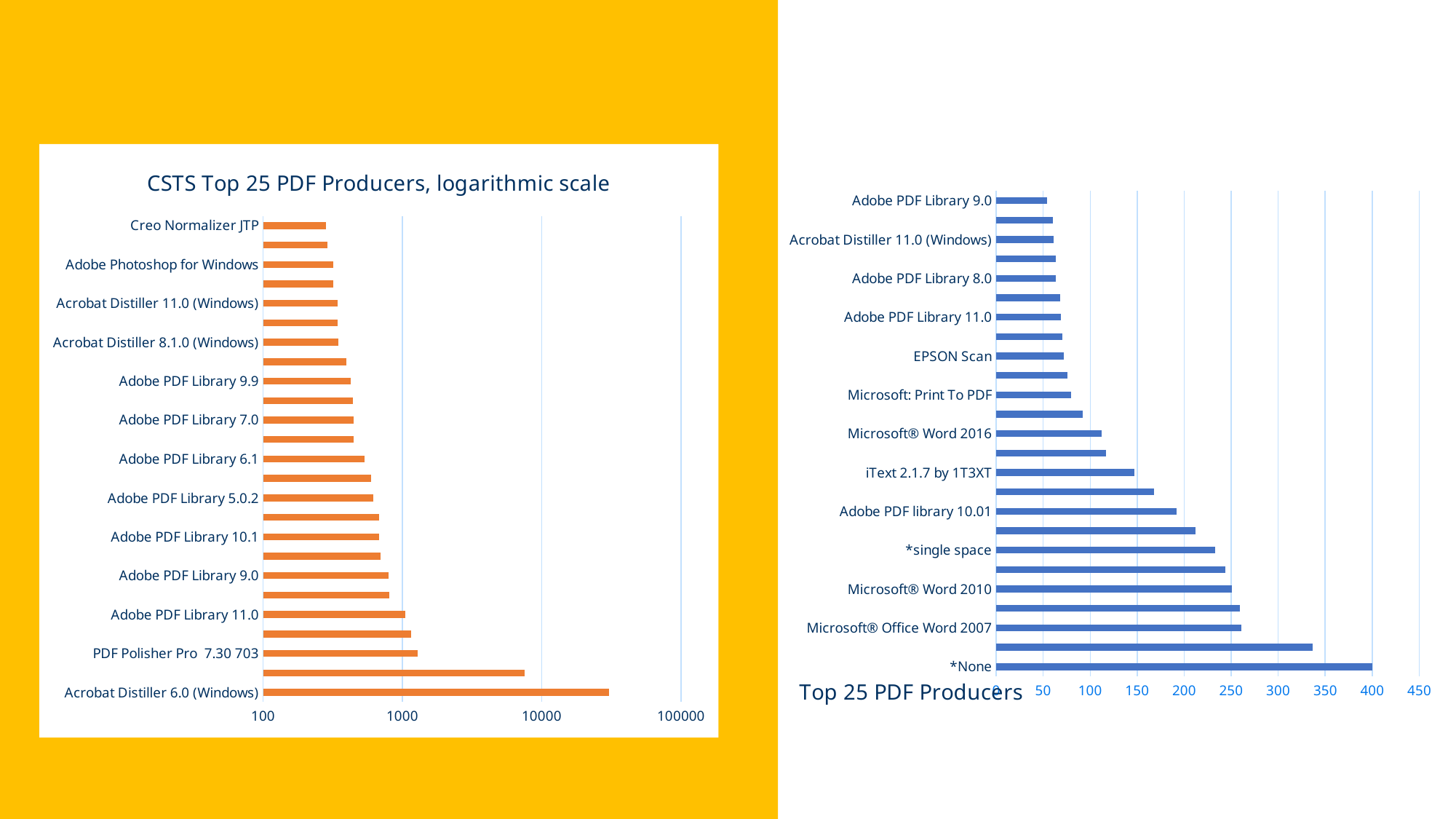
In the 'CSTS Top 25 PDF Producers, logarithmic scale' chart on the left, is the value for Creo Normalizer JTP greater or less than 1000? less What is the title of the chart on the left side of the slide? CSTS Top 25 PDF Producers, logarithmic scale In the 'Top 25 PDF Producers' chart on the right, which producer has the highest value? *None In the 'Top 25 PDF Producers' chart on the right, is the value for *None greater or less than 350? greater In the 'CSTS Top 25 PDF Producers, logarithmic scale' chart on the left, which producer has the highest value? Acrobat Distiller 6.0 (Windows) In the 'Top 25 PDF Producers' chart on the right, is the value for Microsoft® Office Word 2007 greater or less than 200? greater What kind of chart is the 'CSTS Top 25 PDF Producers, logarithmic scale' chart on the left? bar chart In the 'CSTS Top 25 PDF Producers, logarithmic scale' chart on the left, which has the larger value: Adobe PDF Library 6.1 or Adobe PDF Library 9.9? Adobe PDF Library 6.1 In the 'Top 25 PDF Producers' chart on the right, which has the larger value: Microsoft® Word 2010 or EPSON Scan? Microsoft® Word 2010